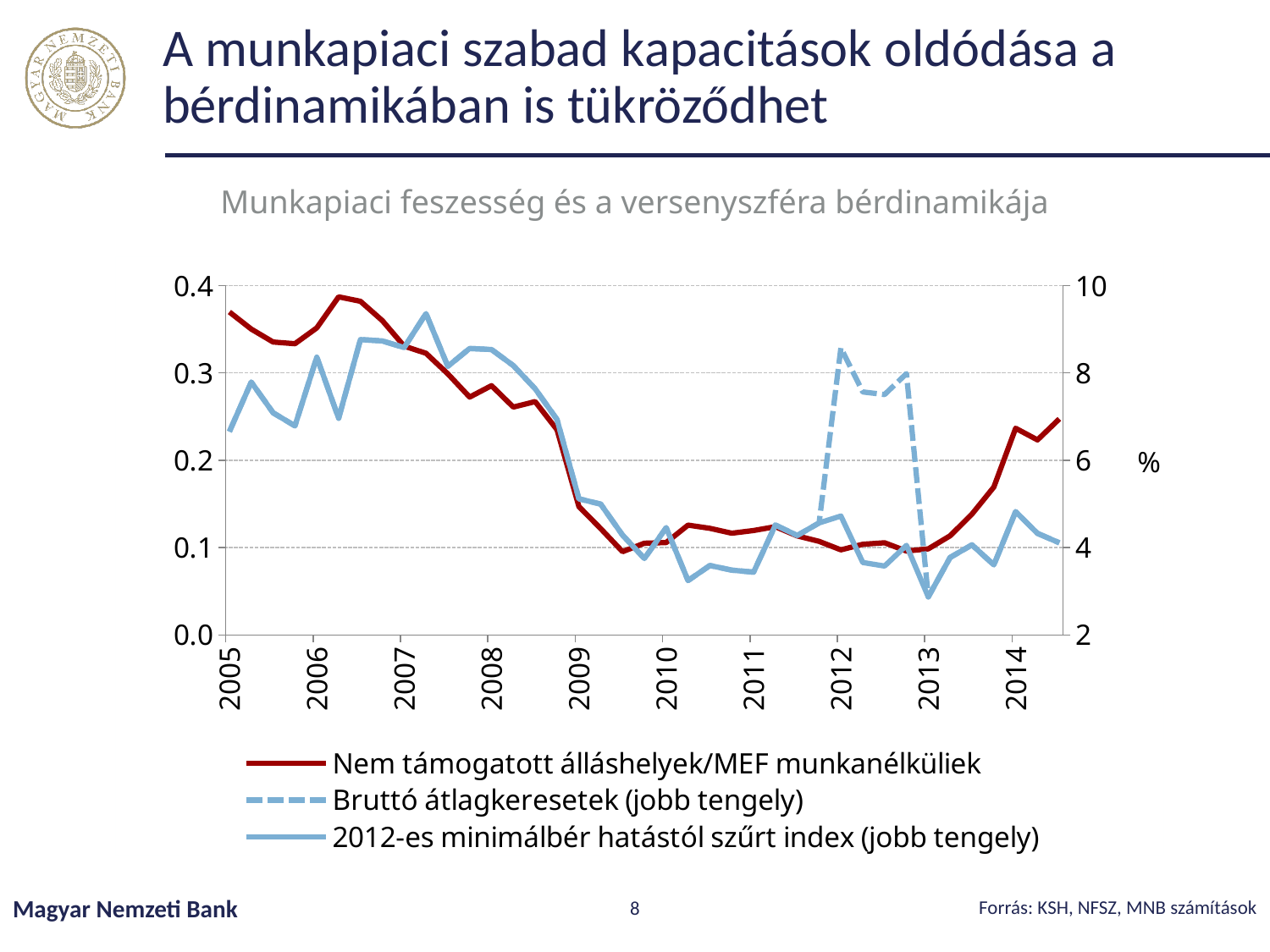
What kind of chart is shown on the slide? line chart Is the value of the 2012-es minimálbér hatástól szűrt index line at 2013 greater or less than 4 on the right axis? less Is the value of the Nem támogatott álláshelyek/MEF munkanélküliek line at 2009 greater or less than 0.2? less Is the value of the Nem támogatott álláshelyek/MEF munkanélküliek line at 2005 greater or less than 0.3? greater Is the Nem támogatott álláshelyek/MEF munkanélküliek line higher at 2005 or at 2014? 2005 Does the Nem támogatott álláshelyek/MEF munkanélküliek line rise or fall between 2006 and 2009? fall What is the title of the chart? Munkapiaci feszesség és a versenyszféra bérdinamikája How many series does the legend list? 3 Does the Nem támogatott álláshelyek/MEF munkanélküliek line rise or fall between 2013 and 2014? rise Which series is drawn with a dashed line? Bruttó átlagkeresetek (jobb tengely) How many year labels are shown on the x axis? 10